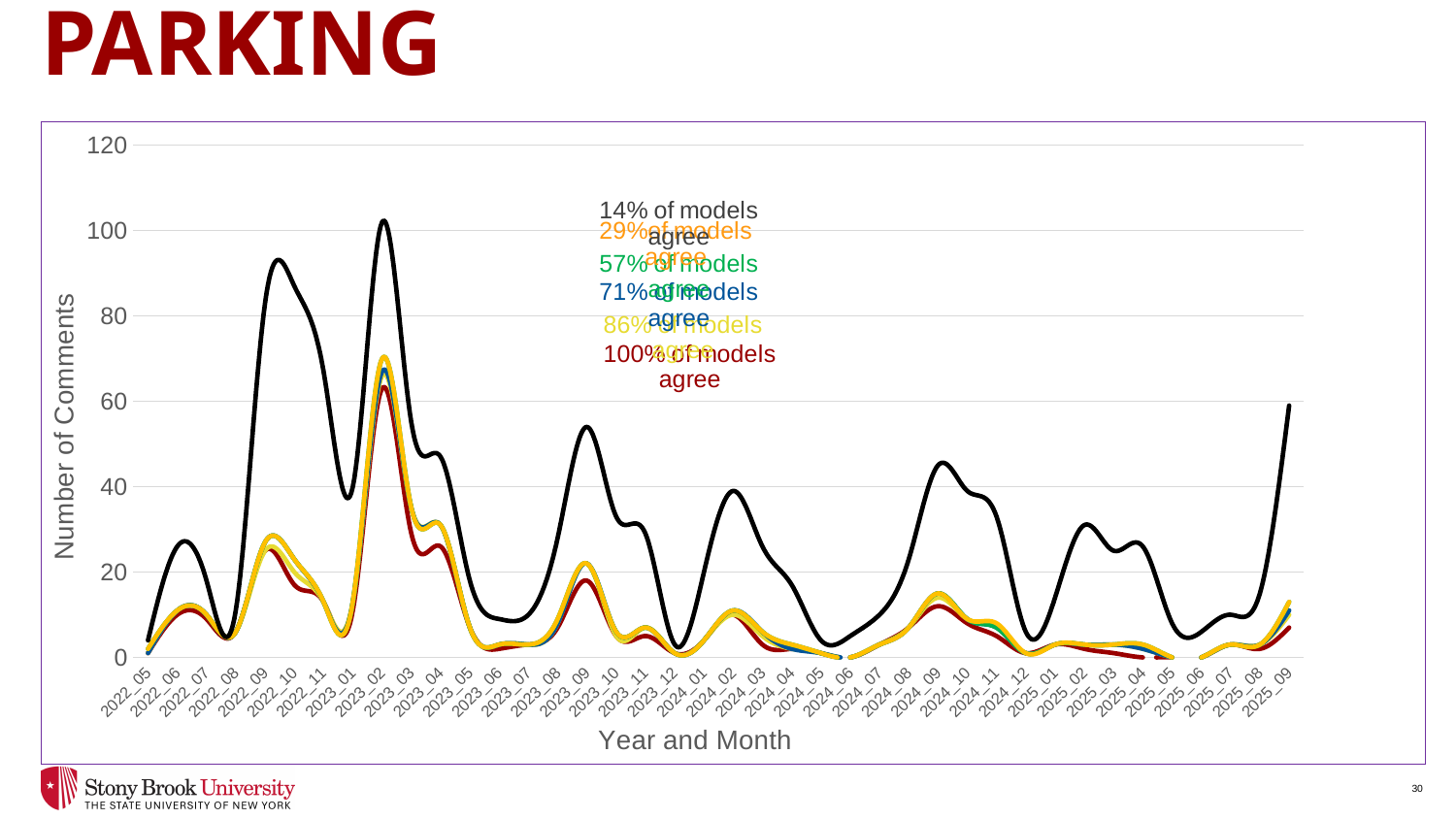
Is the value of the black line at 2023_09 greater or less than 40? greater How many year-month categories are shown on the x axis? 40 Is the value of the black line at 2023_02 greater or less than 100? greater At which year-month does the black line reach its highest value? 2023_02 What is the title of the y axis? Number of Comments Is the value of the black line at 2022_09 greater or less than 80? greater Which is larger for the black line: the value at 2023_02 or the value at 2022_09? 2023_02 Does the black line rise or fall between 2025_07 and 2025_09? rise How many lines are plotted on the chart? 6 What kind of chart is shown on the slide? line chart What is the title of the x axis? Year and Month